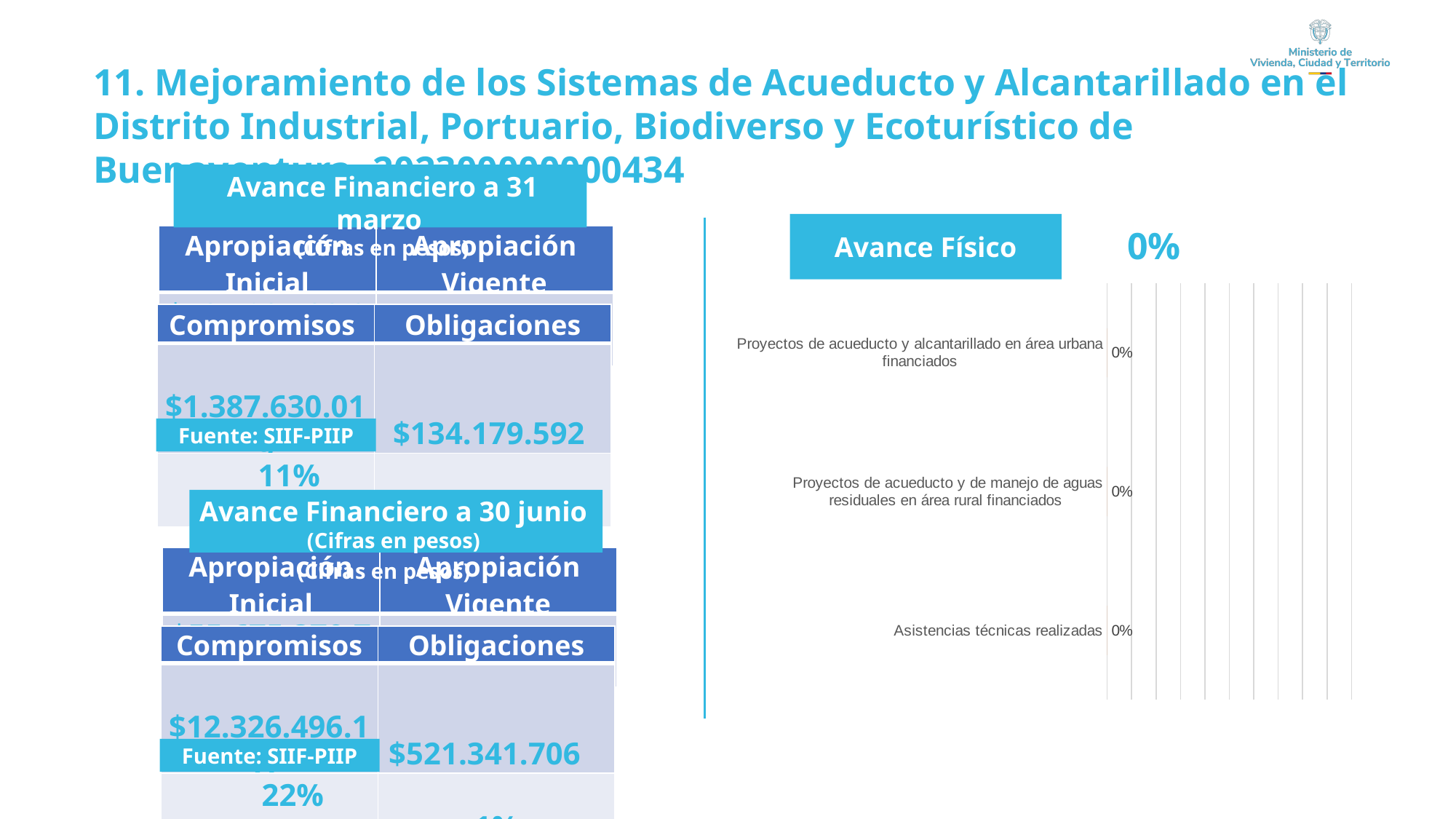
How many categories does the 'Avance Físico' chart show? 3 In the 'Avance Físico' chart, what is the value for 'Proyectos de acueducto y de manejo de aguas residuales en área rural financiados'? 0% What kind of chart is shown under the 'Avance Físico' heading? bar chart What overall percentage is displayed next to the 'Avance Físico' chart title? 0% In the 'Avance Físico' chart, what is the value for 'Asistencias técnicas realizadas'? 0% In the 'Avance Físico' chart, what is the value for 'Proyectos de acueducto y alcantarillado en área urbana financiados'? 0% What is the title of the chart on the right side of the slide? Avance Físico In the 'Avance Físico' chart, what is the difference between the value for 'Asistencias técnicas realizadas' and the value for 'Proyectos de acueducto y alcantarillado en área urbana financiados'? 0%